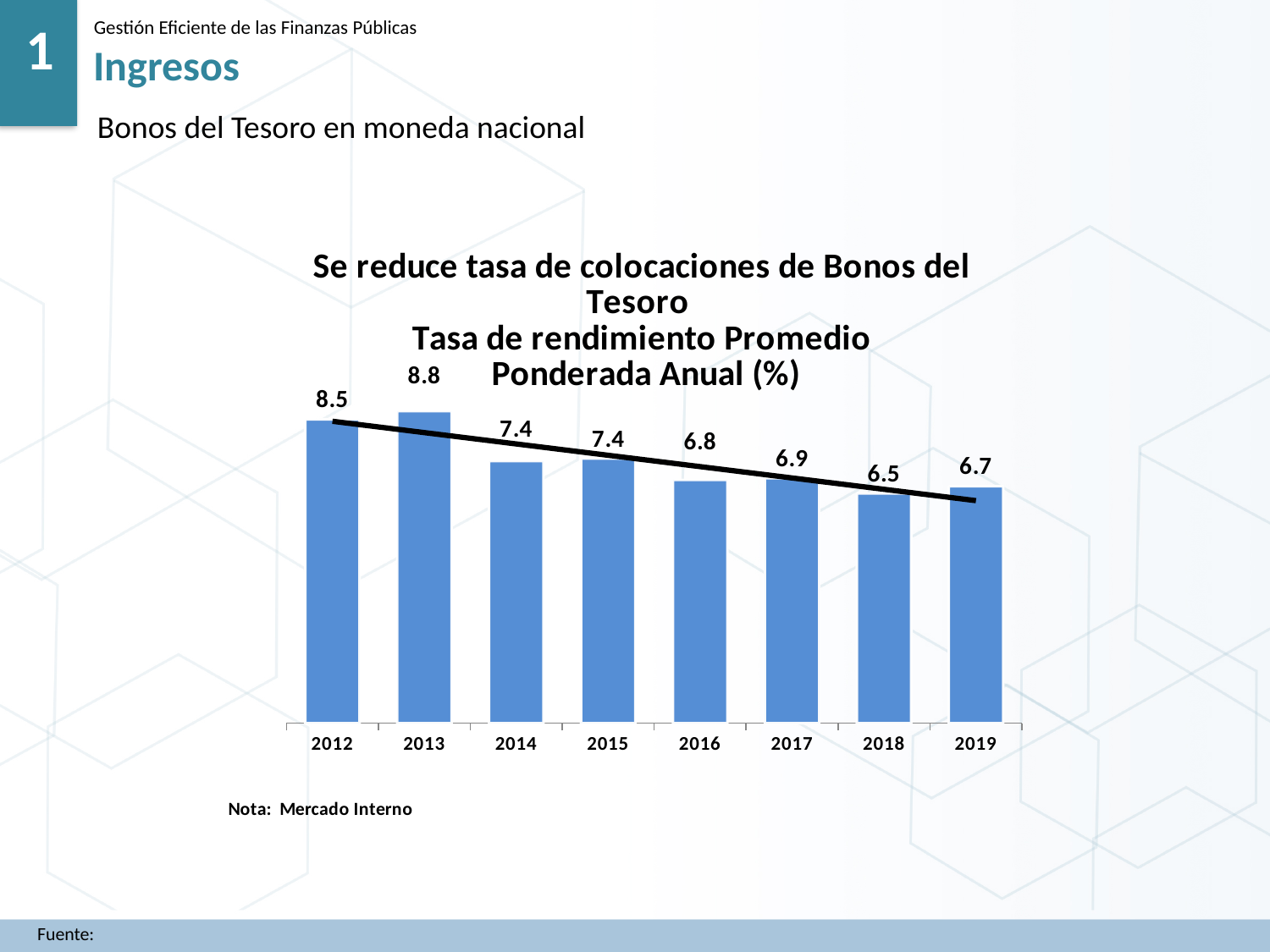
Which is larger, the value for 2017 or the value for 2018? 2017 What is the value for 2019? 6.7 Which year has the lowest value? 2018 Do the values generally rise or fall from 2012 to 2019? Fall What is the difference between the values for 2013 and 2018? 2.3 What is the value for 2012? 8.5 What is the value for 2016? 6.8 How many years are shown on the x axis? 8 What is the difference between the values for 2012 and 2019? 1.8 What note appears below the chart? Nota: Mercado Interno What kind of chart is this? Bar chart Which year has the highest value? 2013